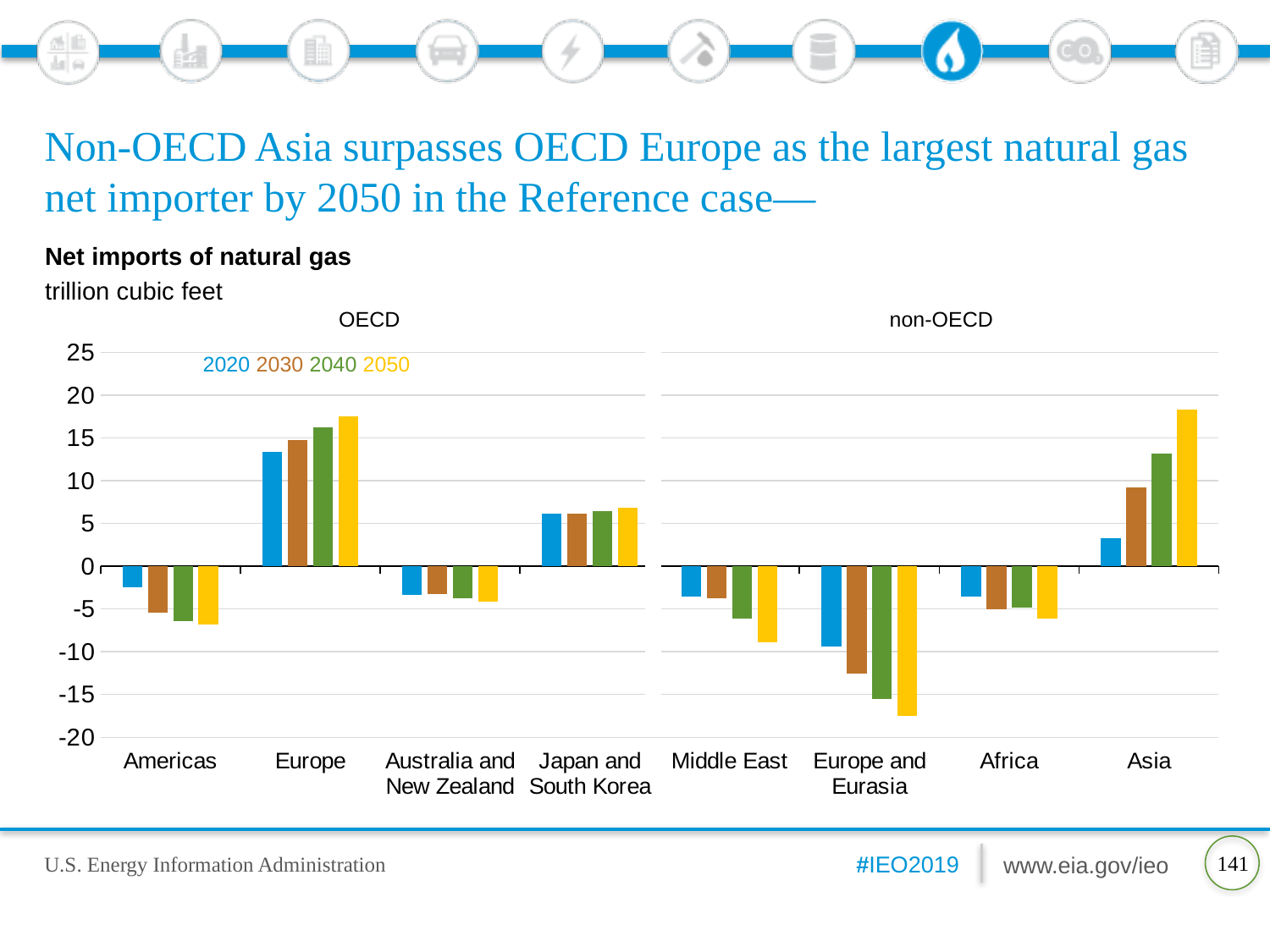
In the OECD chart, which region has the highest net imports in 2050? Europe In the OECD chart, is the 2050 value for Europe greater or less than 15? greater In the non-OECD chart, which region has the highest net imports in 2050? Asia In the OECD chart, how many regions are shown on the x axis? 4 In the non-OECD chart, is the 2050 value for Europe and Eurasia greater or less than -15? less What kind of chart is used on this slide? bar chart In the non-OECD chart, which region has the lowest (most negative) value in 2050? Europe and Eurasia Which years are listed in the legend? 2020, 2030, 2040, 2050 In the non-OECD chart, do the values for Asia rise or fall from 2020 to 2050? rise In the OECD chart, which is larger in 2050: Europe or Japan and South Korea? Europe How many series does the legend list? 4 In the non-OECD chart, how many regions are shown on the x axis? 4